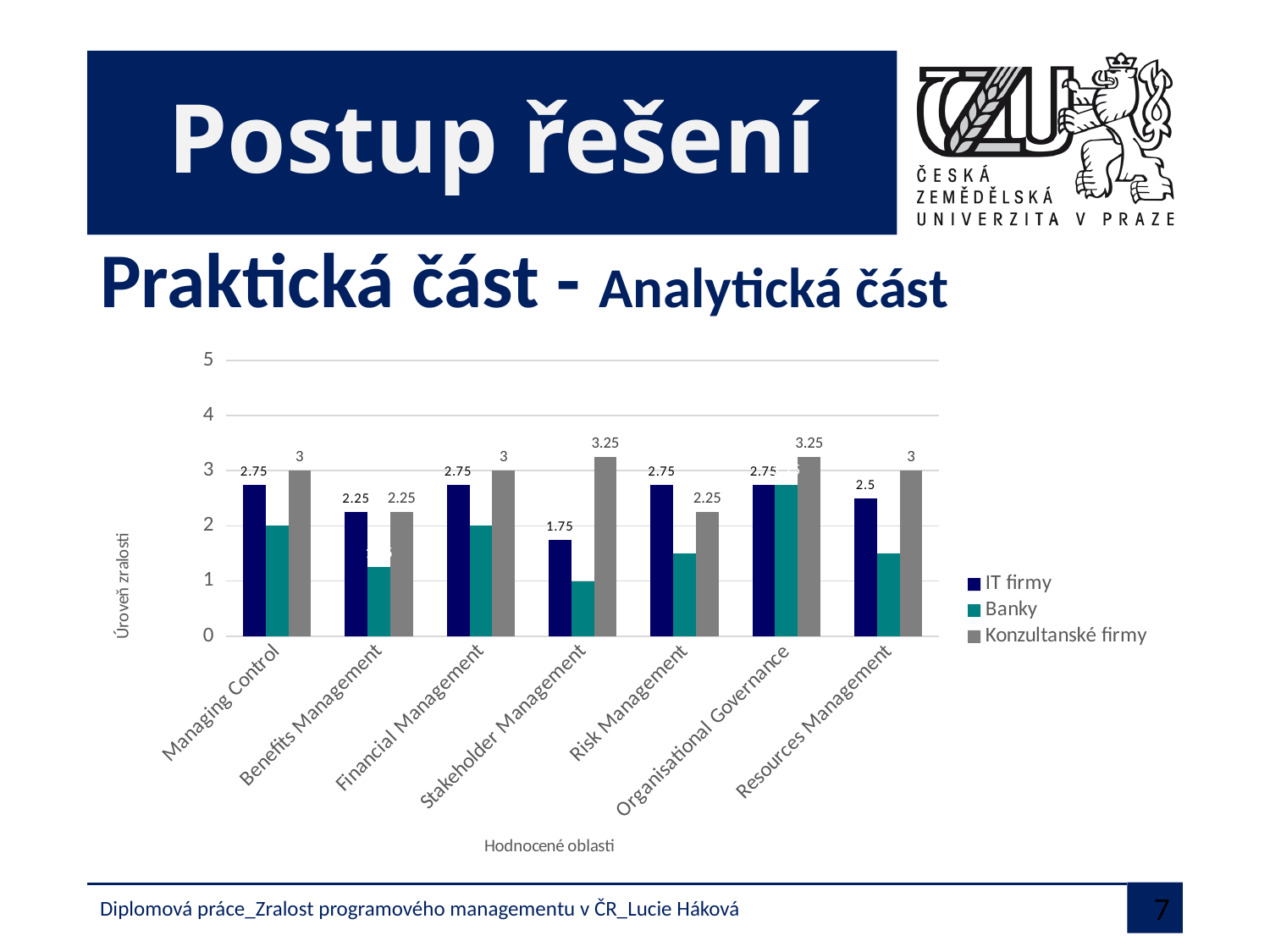
What is the value for IT firmy in Resources Management? 2.5 What kind of chart is shown on the slide? bar chart Is the value for Banky in Risk Management greater or less than 2? less What is the value for Konzultanské firmy in Organisational Governance? 3.25 What is the title of the vertical axis? Úroveň zralosti What is the difference between Konzultanské firmy and IT firmy in Stakeholder Management? 1.5 In Risk Management, which is larger: IT firmy or Konzultanské firmy? IT firmy What is the value for IT firmy in Stakeholder Management? 1.75 How many categories are shown on the x axis? 7 How many series does the legend list? 3 What is the difference between Konzultanské firmy and IT firmy in Managing Control? 0.25 In which category is the IT firmy value lowest? Stakeholder Management